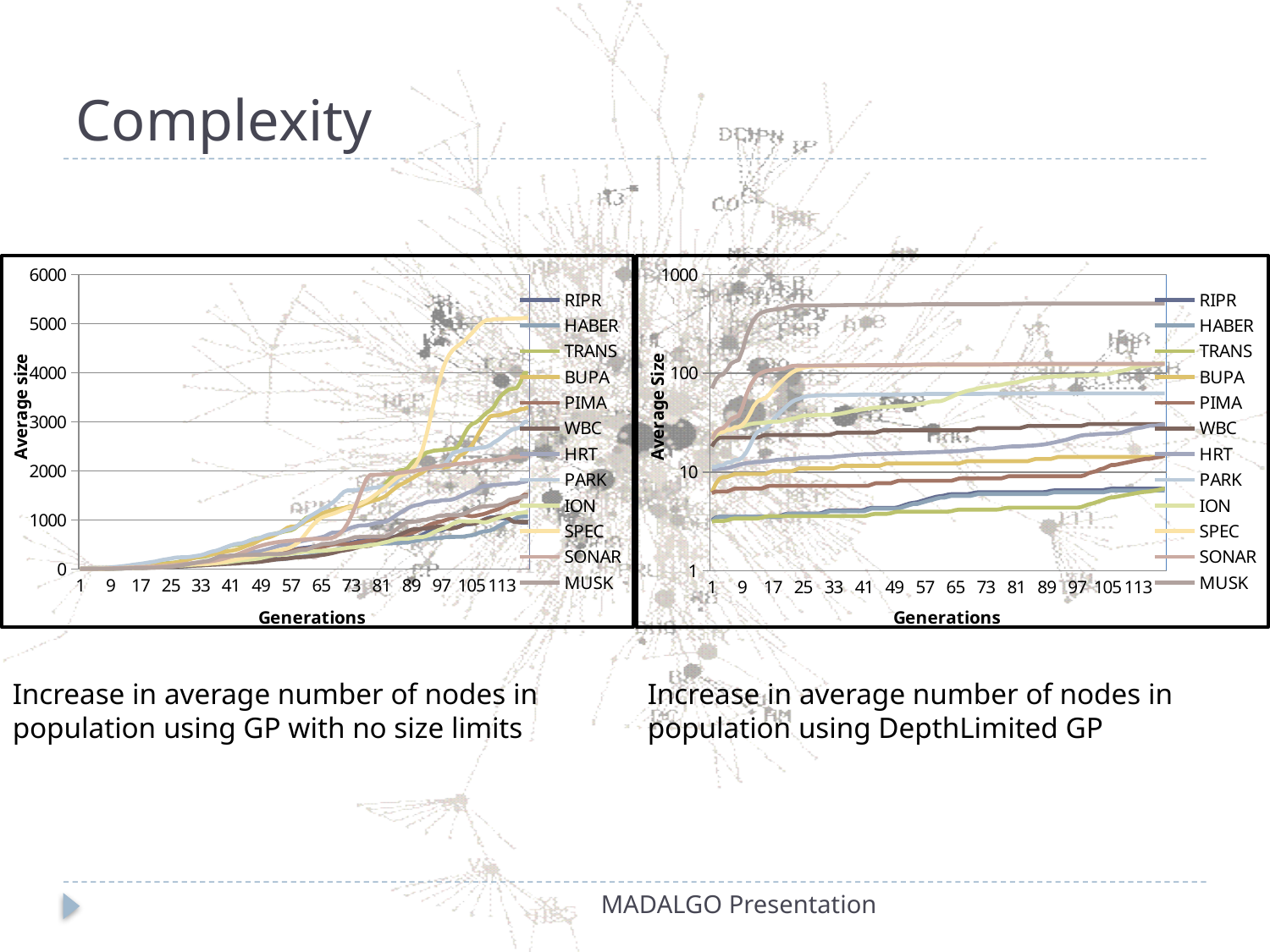
What is the label of the x axis on the left chart (GP with no size limits)? Generations In the right chart (DepthLimited GP), does the MUSK series rise or fall over the generations? rise In the left chart (GP with no size limits), is the value for SPEC at the final generation greater or less than 4000? greater In the left chart (GP with no size limits), which is larger at the final generation, SPEC or PIMA? SPEC In the left chart (GP with no size limits), do the average sizes generally rise or fall as generations increase? rise In the right chart (DepthLimited GP), is the value for ION at the final generation greater or less than 10? greater In the right chart (DepthLimited GP), which series has the highest average size across the generations? MUSK What is the label of the y axis on the right chart (DepthLimited GP)? Average Size In the left chart (GP with no size limits), which series reaches the highest average size by the final generation? SPEC How many series does the legend of the right chart (DepthLimited GP) list? 12 What kind of chart is the left chart (GP with no size limits)? line chart In the right chart (DepthLimited GP), is the value for MUSK at the final generation greater or less than 100? greater